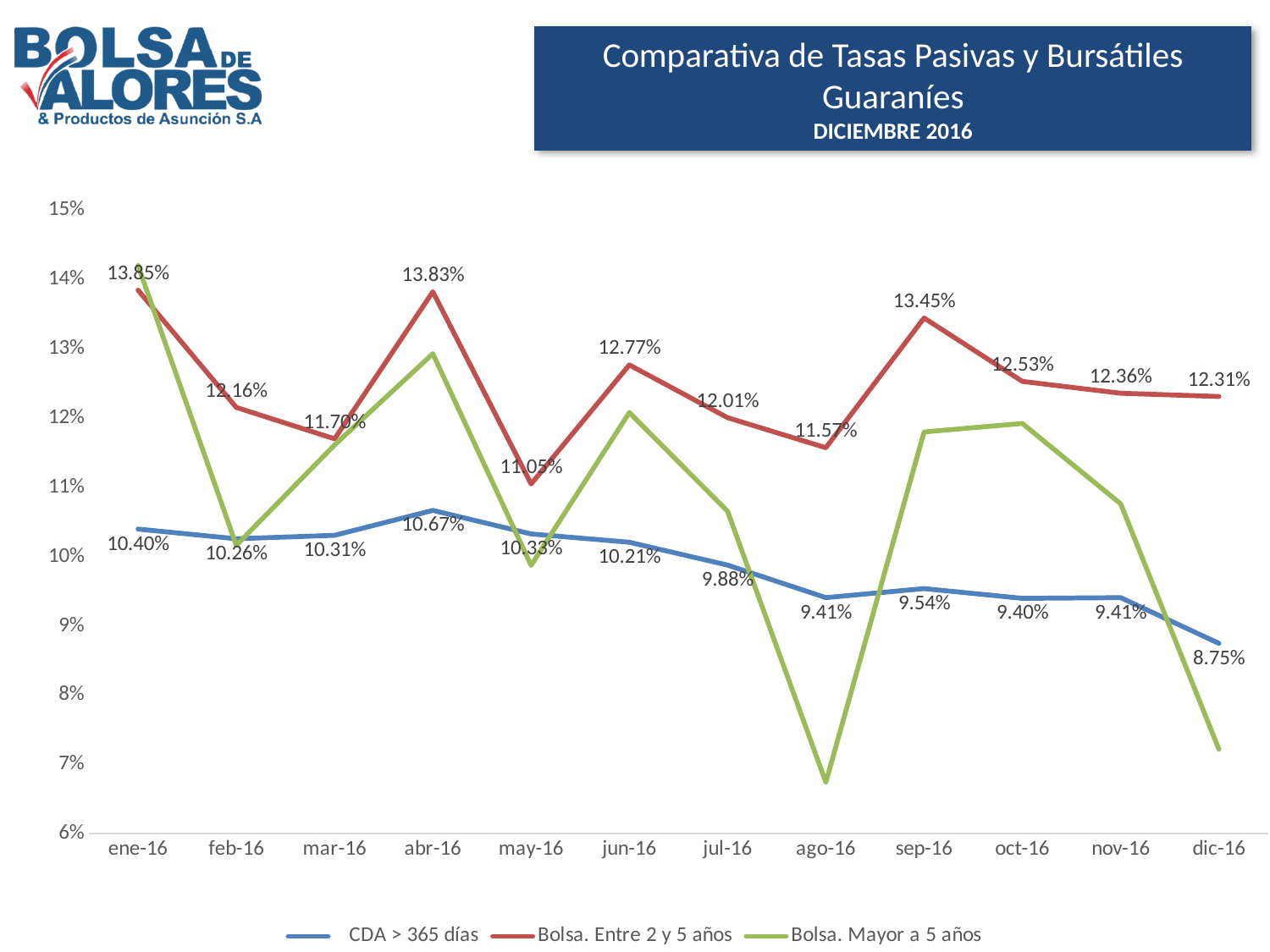
Is the value for Bolsa. Mayor a 5 años in ago-16 greater or less than 8%? less How many series does the legend list? 3 In which month is the Bolsa. Entre 2 y 5 años series highest? ene-16 Which is larger in may-16: Bolsa. Entre 2 y 5 años or CDA > 365 días? Bolsa. Entre 2 y 5 años What is the difference between Bolsa. Entre 2 y 5 años and CDA > 365 días in dic-16? 3.56% What is the value for CDA > 365 días in abr-16? 10.67% In which month is the CDA > 365 días series lowest? dic-16 What is the value for CDA > 365 días in dic-16? 8.75% How many months are shown on the x axis? 12 What kind of chart is shown? line chart What is the value for Bolsa. Entre 2 y 5 años in sep-16? 13.45% Does the CDA > 365 días series generally rise or fall from ene-16 to dic-16? fall